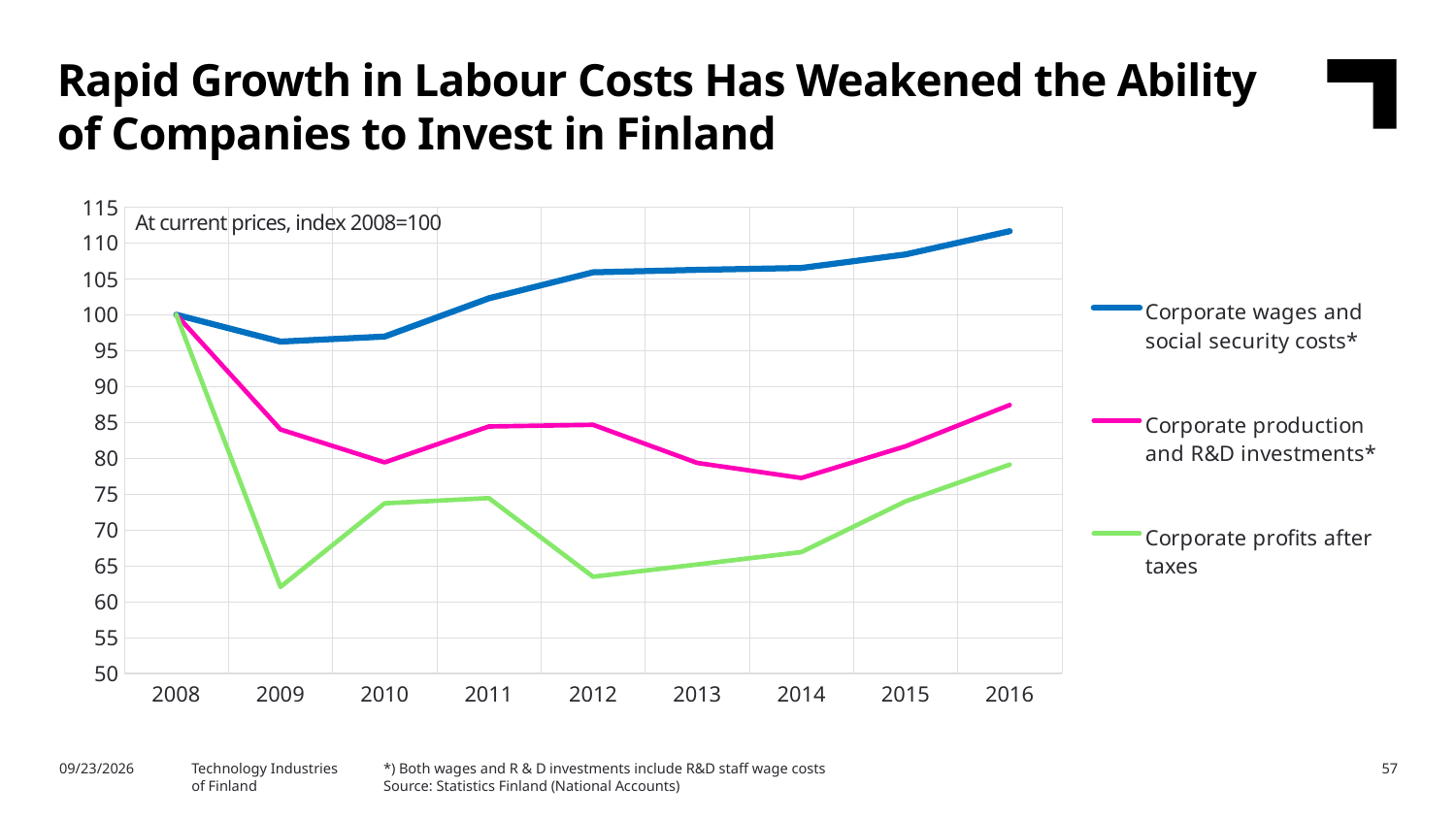
How many series does the legend list? 3 In which year is Corporate wages and social security costs at its highest? 2016 What kind of chart is shown on the slide? line chart In which year is Corporate profits after taxes at its lowest? 2009 What base year and index value does the chart's note state? index 2008=100 In 2016, which is larger: Corporate wages and social security costs or Corporate production and R&D investments? Corporate wages and social security costs What is the value of Corporate profits after taxes in 2008? 100 Is the value for Corporate profits after taxes in 2009 greater or less than 65? less How many years are shown on the x axis? 9 Does Corporate wages and social security costs rise or fall from 2010 to 2016? rise Is the value for Corporate production and R&D investments in 2014 greater or less than 80? less Is the value for Corporate wages and social security costs in 2016 greater or less than 110? greater